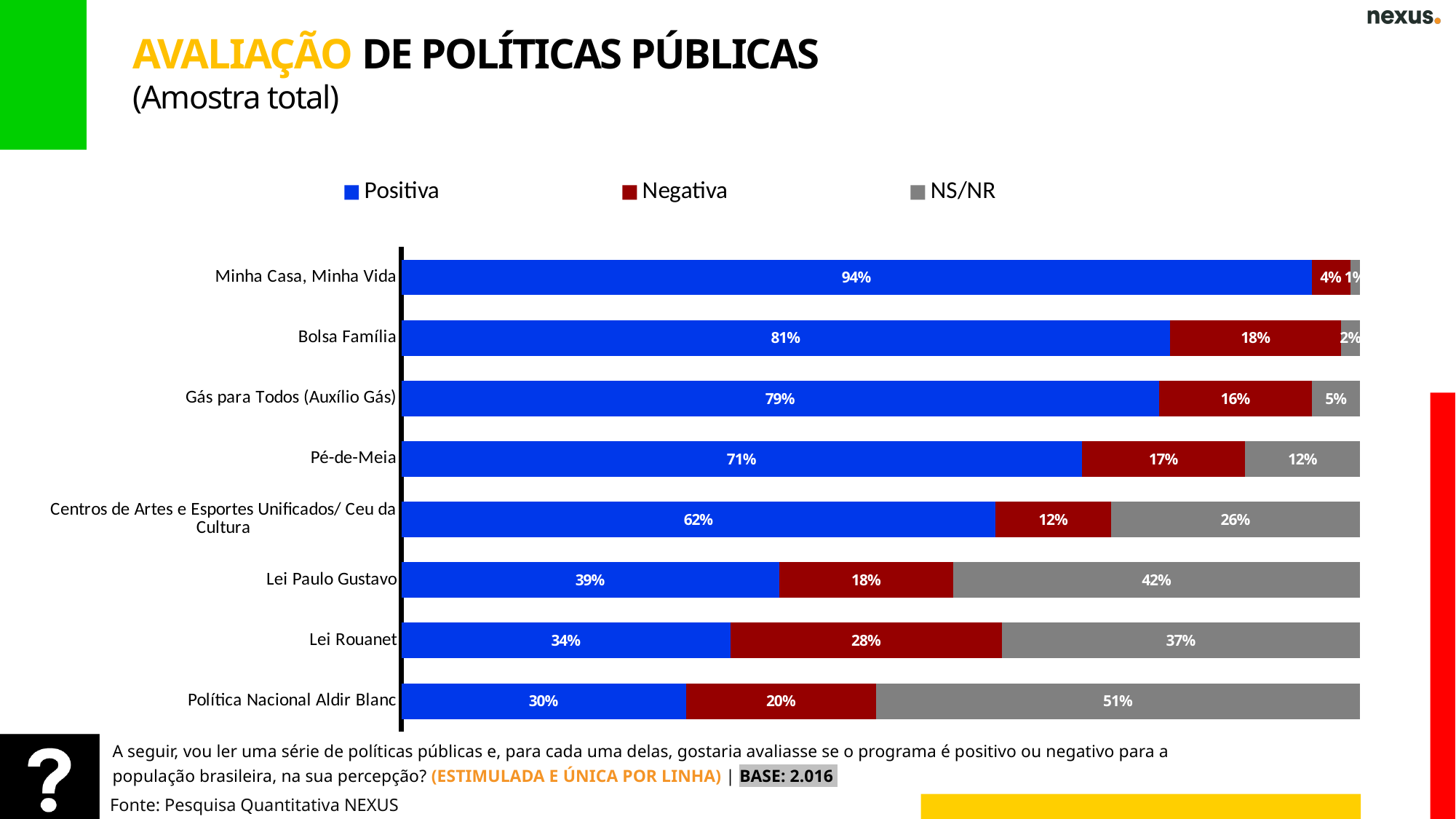
How many series does the legend list? 3 What is the Negativa value for Lei Rouanet? 28% What kind of chart is shown on the slide? Stacked bar chart What is the difference between the Positiva values for Bolsa Família and Pé-de-Meia? 10% What is the Positiva value for Minha Casa, Minha Vida? 94% Which policy has the highest Negativa value? Lei Rouanet What is the NS/NR value for Política Nacional Aldir Blanc? 51% Which policy has the highest Positiva value? Minha Casa, Minha Vida Which policy has the lowest Positiva value? Política Nacional Aldir Blanc Which is larger: the NS/NR value for Lei Paulo Gustavo or for Lei Rouanet? Lei Paulo Gustavo Which colour represents the Negativa series? Dark red How many policies are shown in the chart? 8